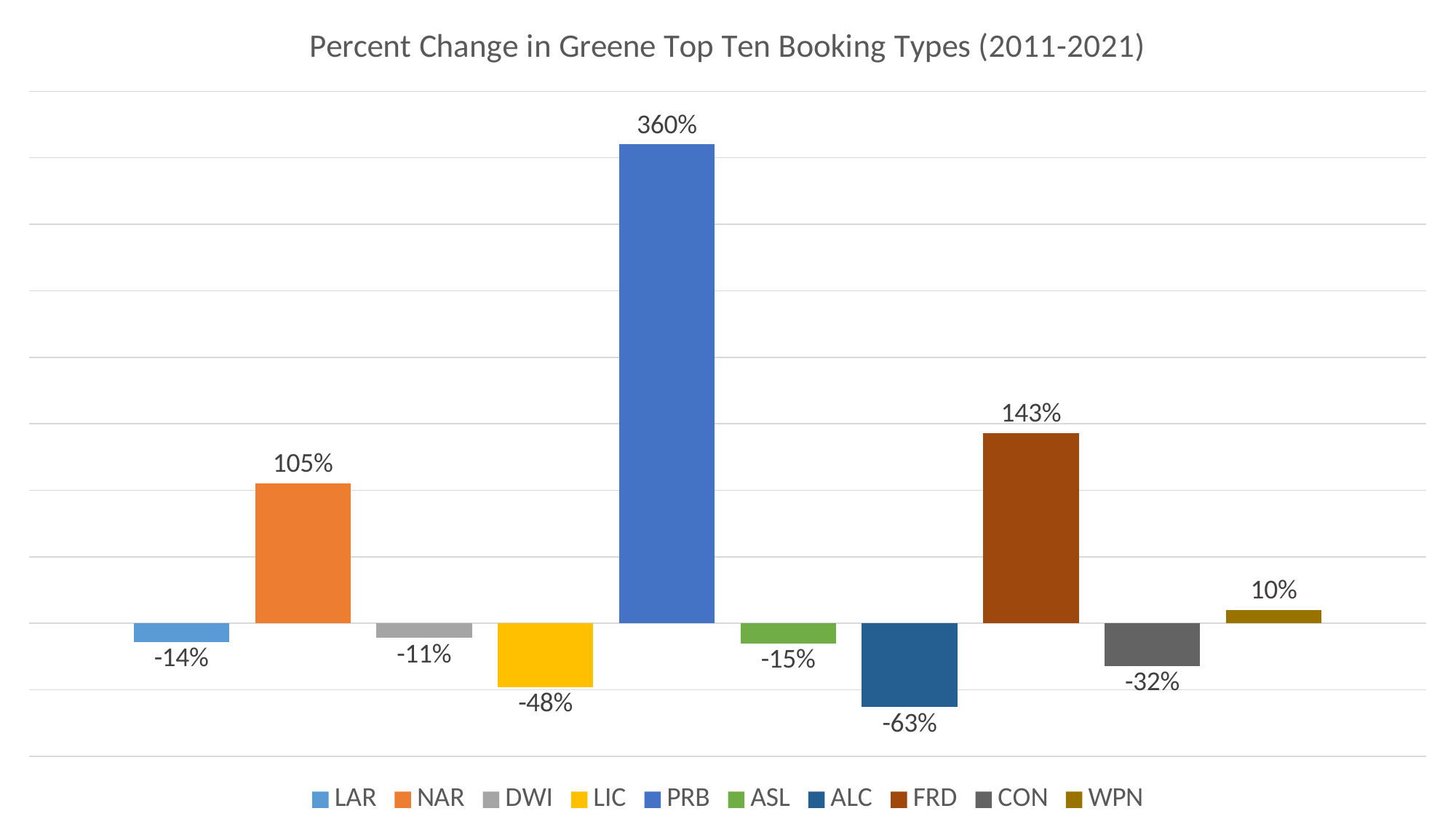
Which has a larger percent change, NAR or FRD? FRD What is the title of the chart? Percent Change in Greene Top Ten Booking Types (2011-2021) Which booking type has the highest percent change? PRB Which booking type has the lowest percent change? ALC What is the percent change for PRB? 360% What is the percent change for CON? -32% What type of chart is shown on the slide? Bar chart What is the difference between the percent change for PRB and the percent change for FRD? 217% What is the difference between the percent change for NAR and the percent change for WPN? 95% What is the percent change for WPN? 10% What is the percent change for ALC? -63% How many booking types are shown in the chart? 10